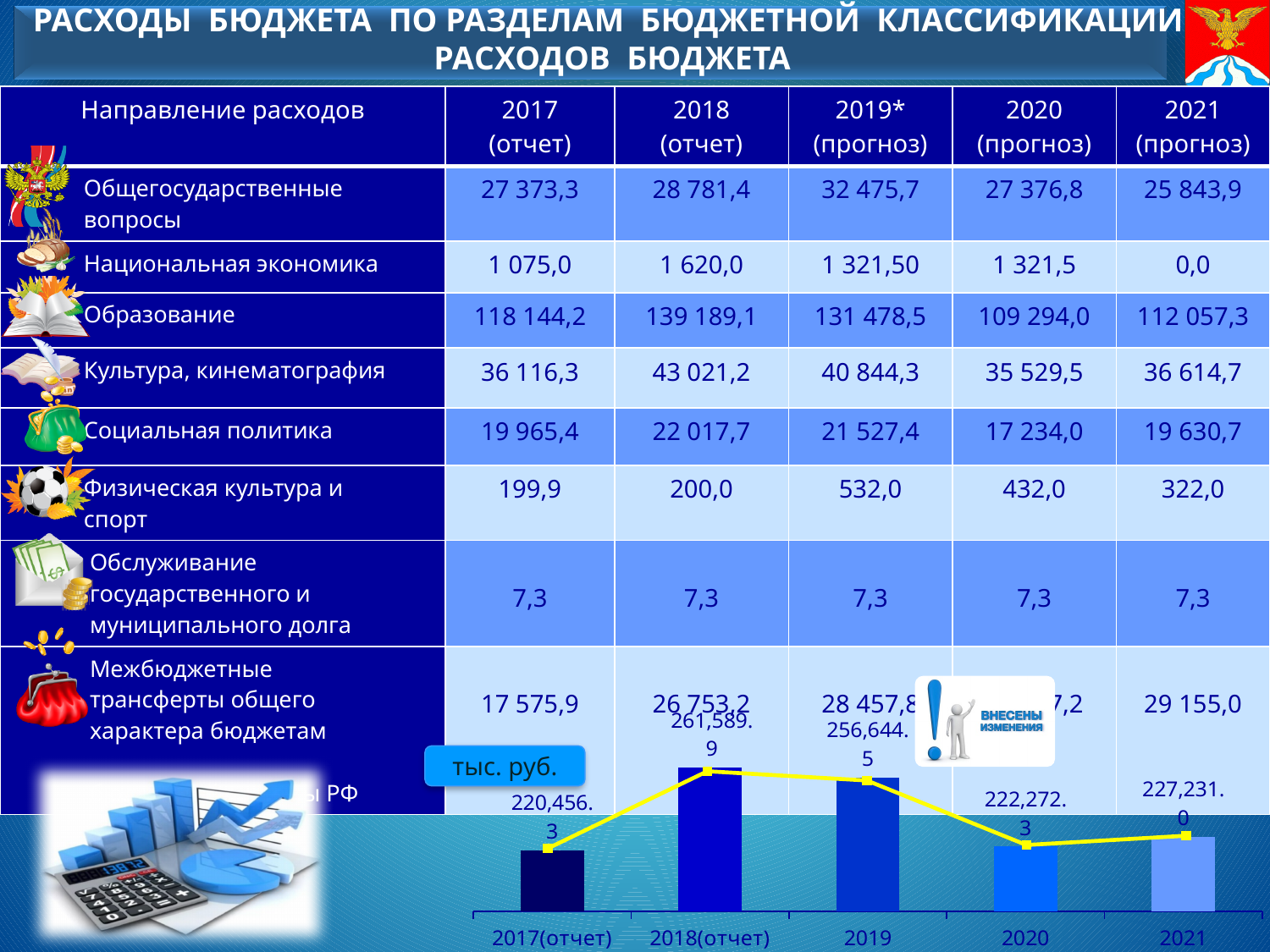
In the bar chart at the bottom of the slide, what is the difference between the values for 2018(отчет) and 2017(отчет)? 41,133.6 What is the value shown for 2021 in the bar chart at the bottom of the slide? 227,231.0 What is the value shown for 2018(отчет) in the bar chart at the bottom of the slide? 261,589.9 In the bar chart at the bottom of the slide, do the values rise or fall from 2018(отчет) to 2020? Fall How many years are plotted in the bar chart at the bottom of the slide? 5 What is the value shown for 2019 in the bar chart at the bottom of the slide? 256,644.5 What is the value shown for 2017(отчет) in the bar chart at the bottom of the slide? 220,456.3 In the bar chart at the bottom of the slide, which year has the lowest value? 2017(отчет) In the bar chart at the bottom of the slide, which year has the highest value? 2018(отчет) In the bar chart at the bottom of the slide, which is larger: the value for 2019 or the value for 2021? 2019 In the bar chart at the bottom of the slide, what is the difference between the values for 2021 and 2020? 4,958.7 What kind of chart is shown at the bottom of the slide? Bar chart with a line overlay